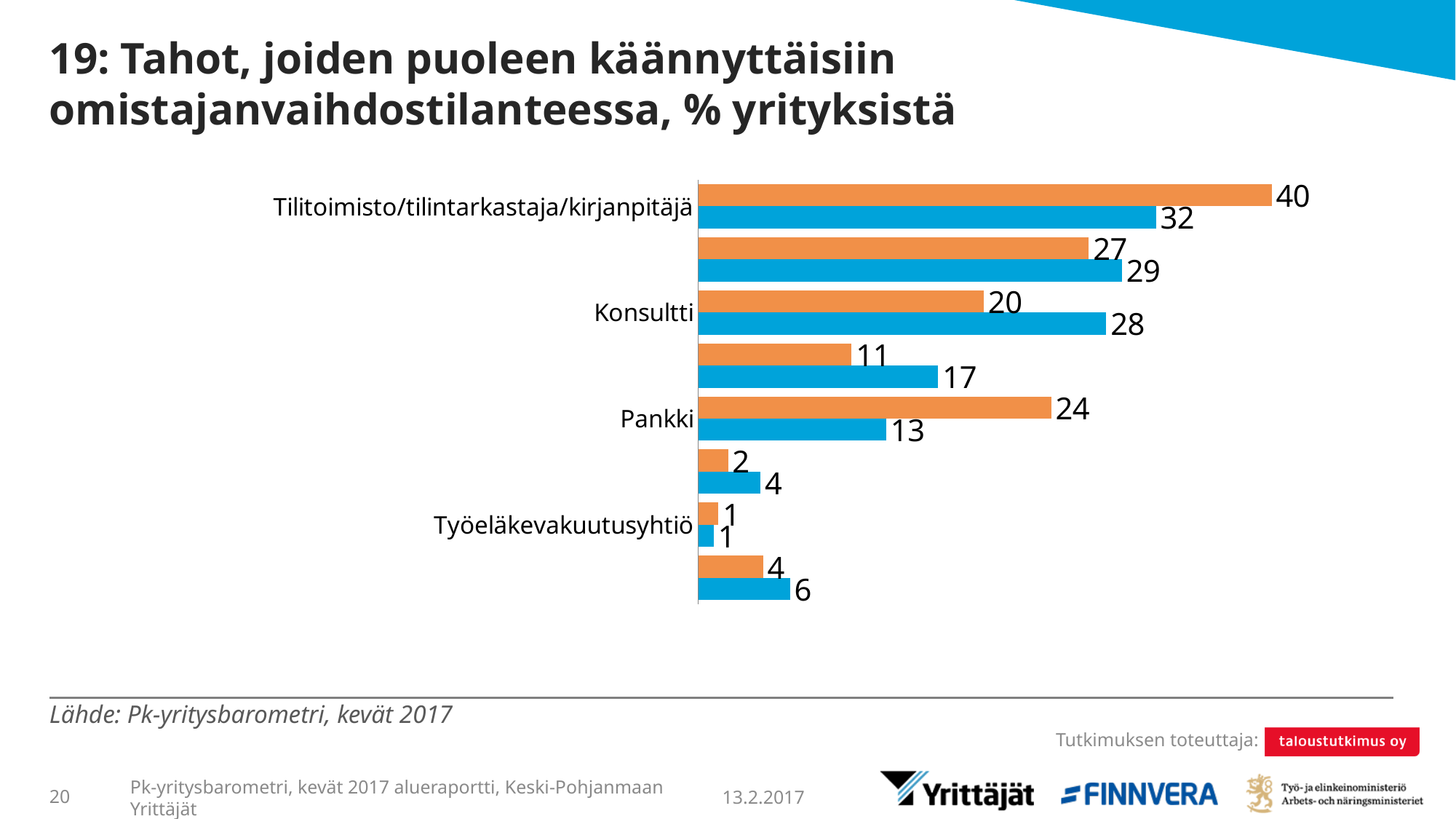
What is the value of the blue bar for Tilitoimisto/tilintarkastaja/kirjanpitäjä? 32 What is the difference between the orange bar values for Tilitoimisto/tilintarkastaja/kirjanpitäjä and Konsultti? 20 For Konsultti, which bar is larger, the orange or the blue one? blue What is the value of the orange bar for Pankki? 24 What type of chart is shown on the slide? bar chart Which labelled category has the lowest blue bar value? Työeläkevakuutusyhtiö Which labelled category has the highest orange bar value? Tilitoimisto/tilintarkastaja/kirjanpitäjä How many categories (pairs of bars) are plotted in the chart? 8 What is the value of the blue bar for Konsultti? 28 What is the value of the blue bar for Työeläkevakuutusyhtiö? 1 What is the difference between the orange and blue bar values for Pankki? 11 What is the value of the orange bar for Tilitoimisto/tilintarkastaja/kirjanpitäjä? 40